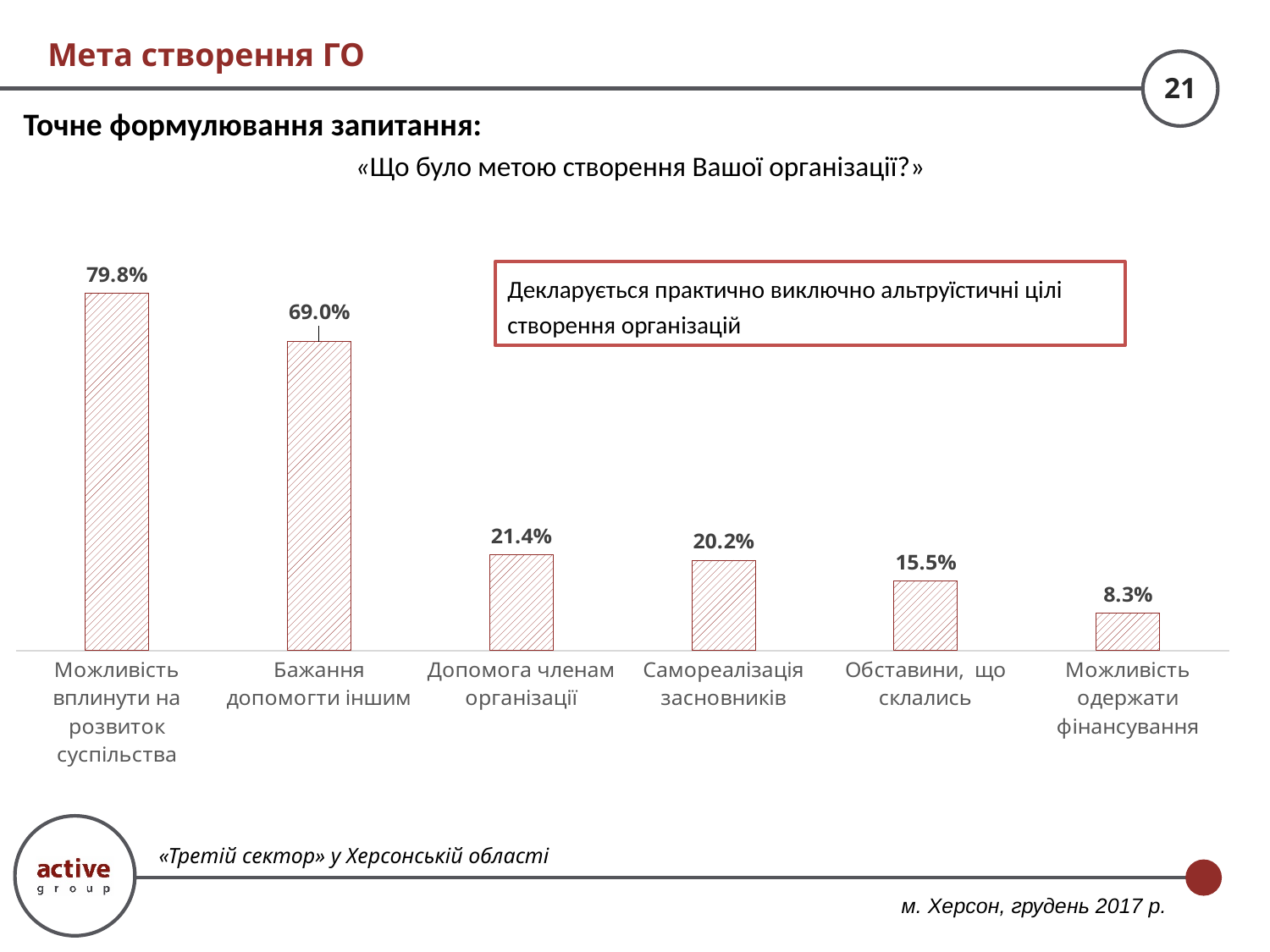
What is the value for «Самореалізація засновників»? 20.2% What is the value for «Допомога членам організації»? 21.4% What is the difference between «Можливість вплинути на розвиток суспільства» and «Бажання допомогти іншим»? 10.8% What is the value for «Можливість одержати фінансування»? 8.3% Which category has the highest value? Можливість вплинути на розвиток суспільства Which category has the lowest value? Можливість одержати фінансування Which is larger: «Обставини, що склались» or «Можливість одержати фінансування»? Обставини, що склались What is the value for «Бажання допомогти іншим»? 69.0% What is the value for «Обставини, що склались»? 15.5% What is the value for «Можливість вплинути на розвиток суспільства»? 79.8% How many categories are shown in the chart? 6 What kind of chart is shown on the slide? Bar chart